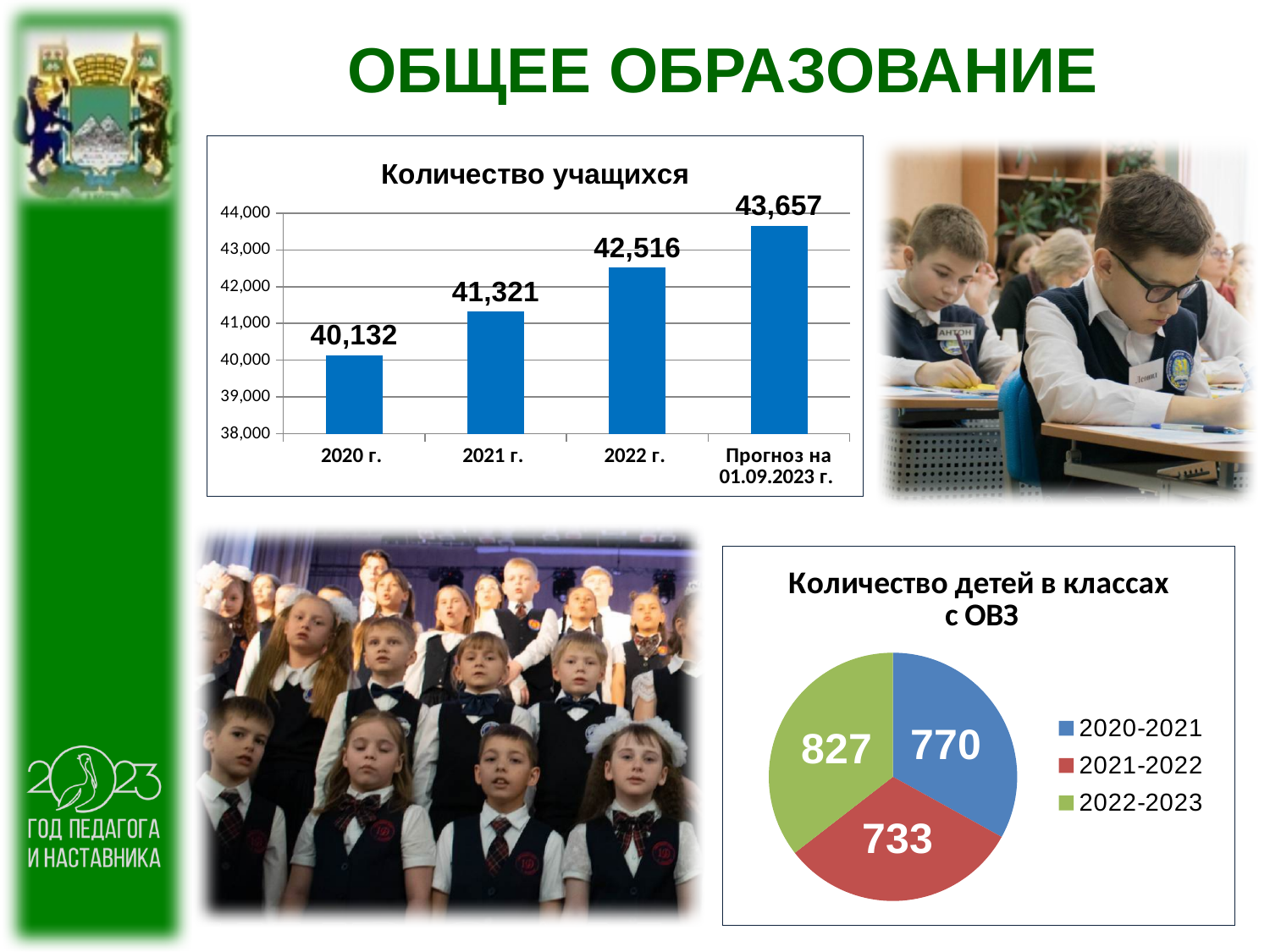
In the chart titled "Количество детей в классах с ОВЗ", which category has the highest value? 2022-2023 In the chart titled "Количество детей в классах с ОВЗ", how many entries does the legend list? 3 What kind of chart is the chart titled "Количество учащихся"? bar chart In the chart titled "Количество учащихся", how many bars are plotted? 4 In the chart titled "Количество учащихся", what is the value for Прогноз на 01.09.2023 г.? 43,657 In the chart titled "Количество учащихся", do the values rise or fall from 2020 г. to Прогноз на 01.09.2023 г.? rise In the chart titled "Количество учащихся", what is the value for 2021 г.? 41,321 In the chart titled "Количество детей в классах с ОВЗ", which is larger: the value for 2020-2021 or the value for 2021-2022? 2020-2021 In the chart titled "Количество учащихся", which category has the lowest value? 2020 г. In the chart titled "Количество детей в классах с ОВЗ", what is the value for 2021-2022? 733 In the chart titled "Количество детей в классах с ОВЗ", what colour is the slice for 2022-2023? green In the chart titled "Количество учащихся", what is the difference between the values for 2022 г. and 2020 г.? 2,384